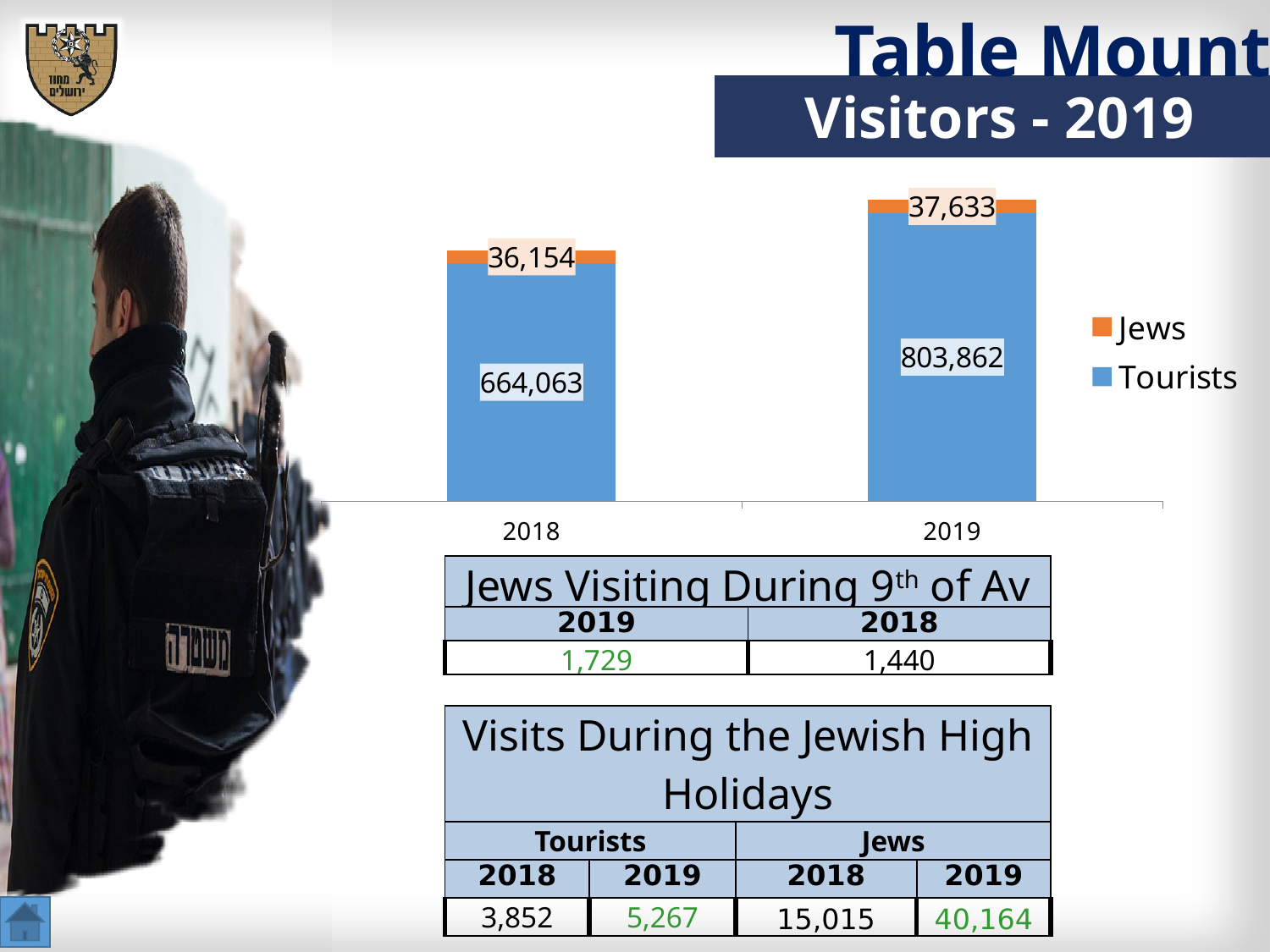
What is the total of the stacked bar for 2019? 841,495 How many series does the legend list? 2 What kind of chart is shown on the slide? Stacked bar chart Which year has the lower number of Jews? 2018 What is the difference in Tourists between 2019 and 2018? 139,799 Which year has the higher number of Tourists? 2019 What is the value for Tourists in 2018? 664,063 What is the value for Jews in 2018? 36,154 What is the total of the stacked bar for 2018? 700,217 What is the value for Tourists in 2019? 803,862 What is the value for Jews in 2019? 37,633 What is the difference in Jews between 2019 and 2018? 1,479